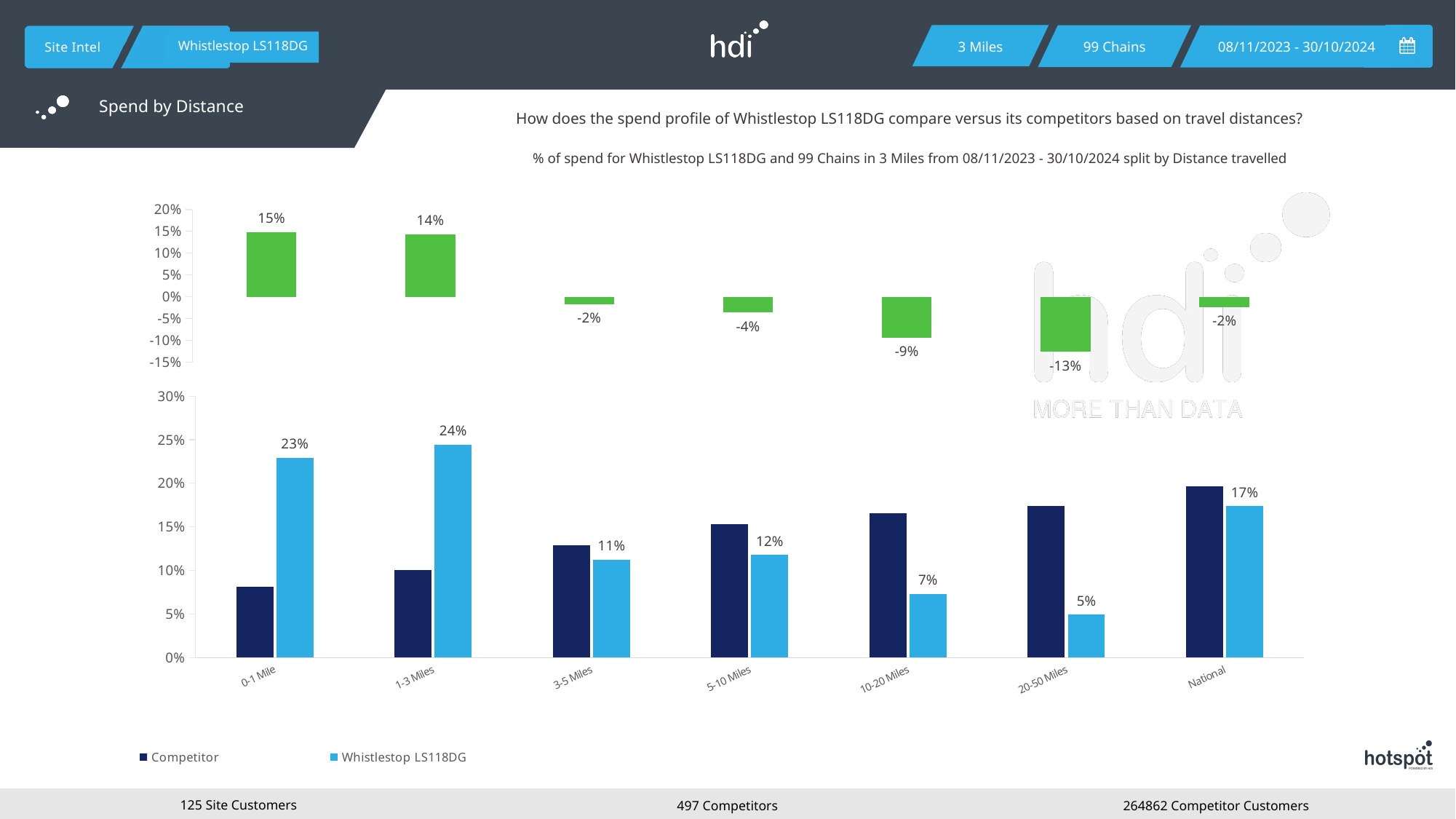
How many distance categories are shown on the x axis of the bottom chart? 7 In the bottom chart, for 20-50 Miles, which series has the larger value, Competitor or Whistlestop LS118DG? Competitor How many series does the legend of the bottom chart list? 2 In the bottom chart, what is the Whistlestop LS118DG value for 20-50 Miles? 5% In the bottom chart, which distance band has the highest Whistlestop LS118DG value? 1-3 Miles In the top chart, which distance band has the highest value? 0-1 Mile In the bottom chart, what is the difference between the Whistlestop LS118DG values for 0-1 Mile and 10-20 Miles? 16% What type of chart is the bottom chart? Bar chart In the bottom chart, what is the Whistlestop LS118DG value for 1-3 Miles? 24% In the top chart, which distance band has the lowest value? 20-50 Miles In the bottom chart, is the Competitor value for 0-1 Mile greater or less than 10%? less In the top chart, what is the value for 10-20 Miles? -9%